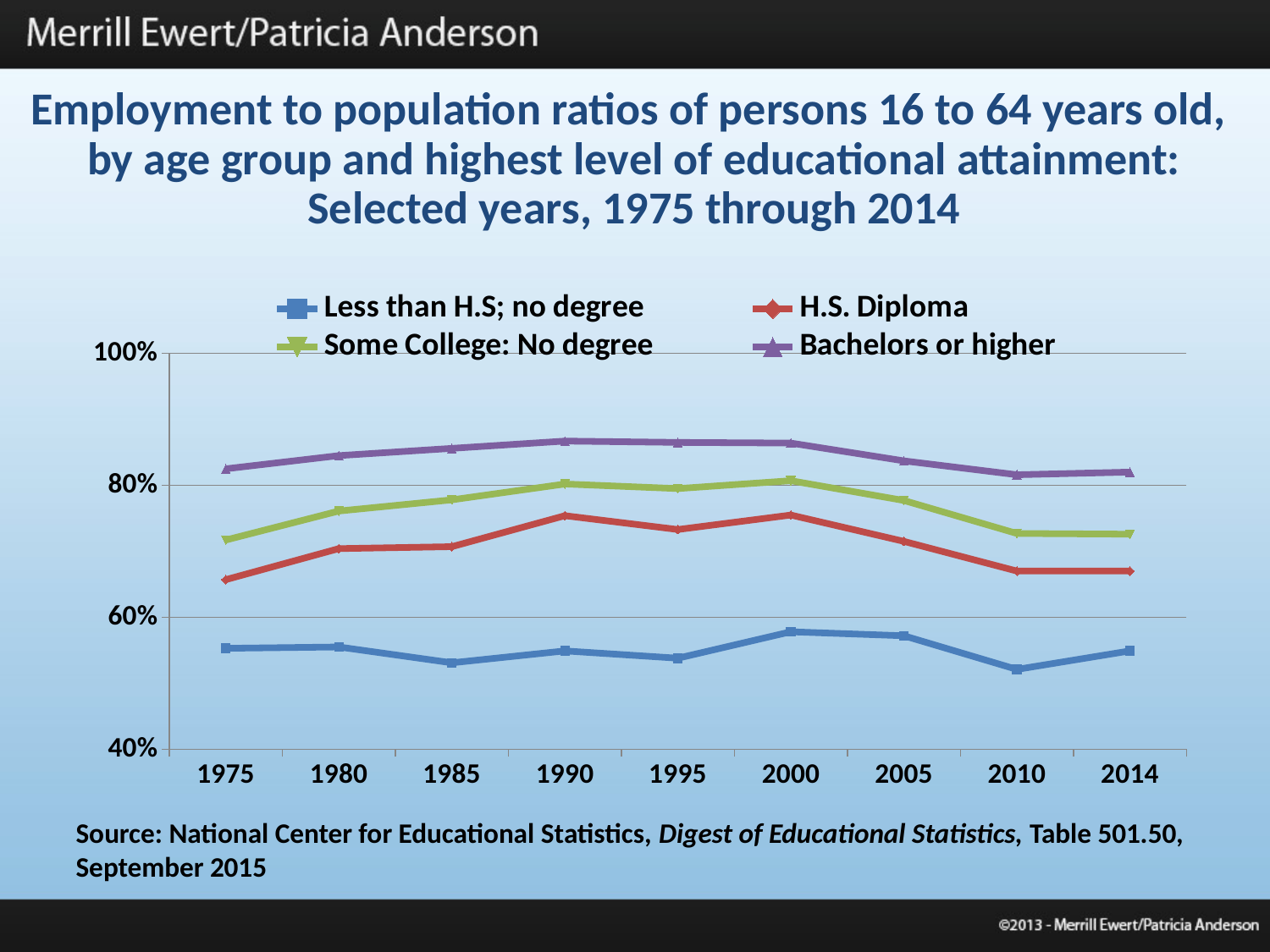
In 1985, which is larger: the value for Some College: No degree or the value for H.S. Diploma? Some College: No degree Does the Bachelors or higher line rise or fall from 1975 to 1990? rise Which series has the lowest employment to population ratio in every year shown? Less than H.S; no degree How many series does the legend list? 4 Which series has the highest employment to population ratio in every year shown? Bachelors or higher Is the value for H.S. Diploma in 2000 greater or less than 80%? less Is the value for Less than H.S; no degree in 2010 greater or less than 60%? less What kind of chart is shown on the slide? line chart Is the value for Some College: No degree in 2014 greater or less than 80%? less How many years are plotted along the x axis? 9 Which series is drawn in red? H.S. Diploma